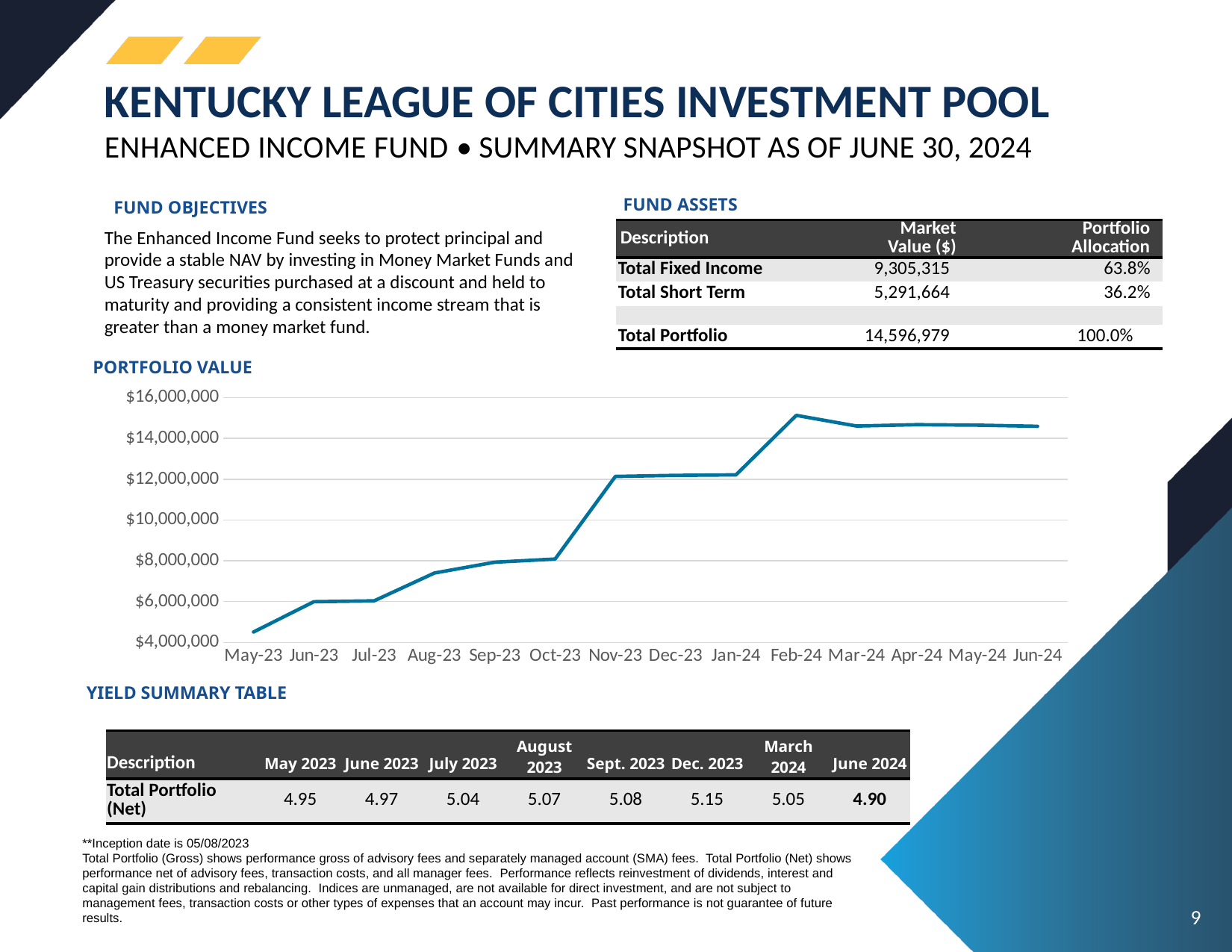
In the Portfolio Value chart, is the value for Nov-23 greater or less than $10,000,000? greater In the Portfolio Value chart, is the value for Aug-23 greater or less than $8,000,000? less What kind of chart is shown under the heading PORTFOLIO VALUE? line chart How many months are plotted on the x axis of the Portfolio Value chart? 14 In the Portfolio Value chart, which month has the lowest portfolio value? May-23 In the Portfolio Value chart, is the value for Jan-24 greater or less than $14,000,000? less In the Portfolio Value chart, which month has the larger portfolio value, Oct-23 or Nov-23? Nov-23 Overall, does the portfolio value rise or fall from May-23 to Jun-24 in the Portfolio Value chart? rise What is the highest value shown on the y axis of the Portfolio Value chart? $16,000,000 In the Portfolio Value chart, which month has the highest portfolio value? Feb-24